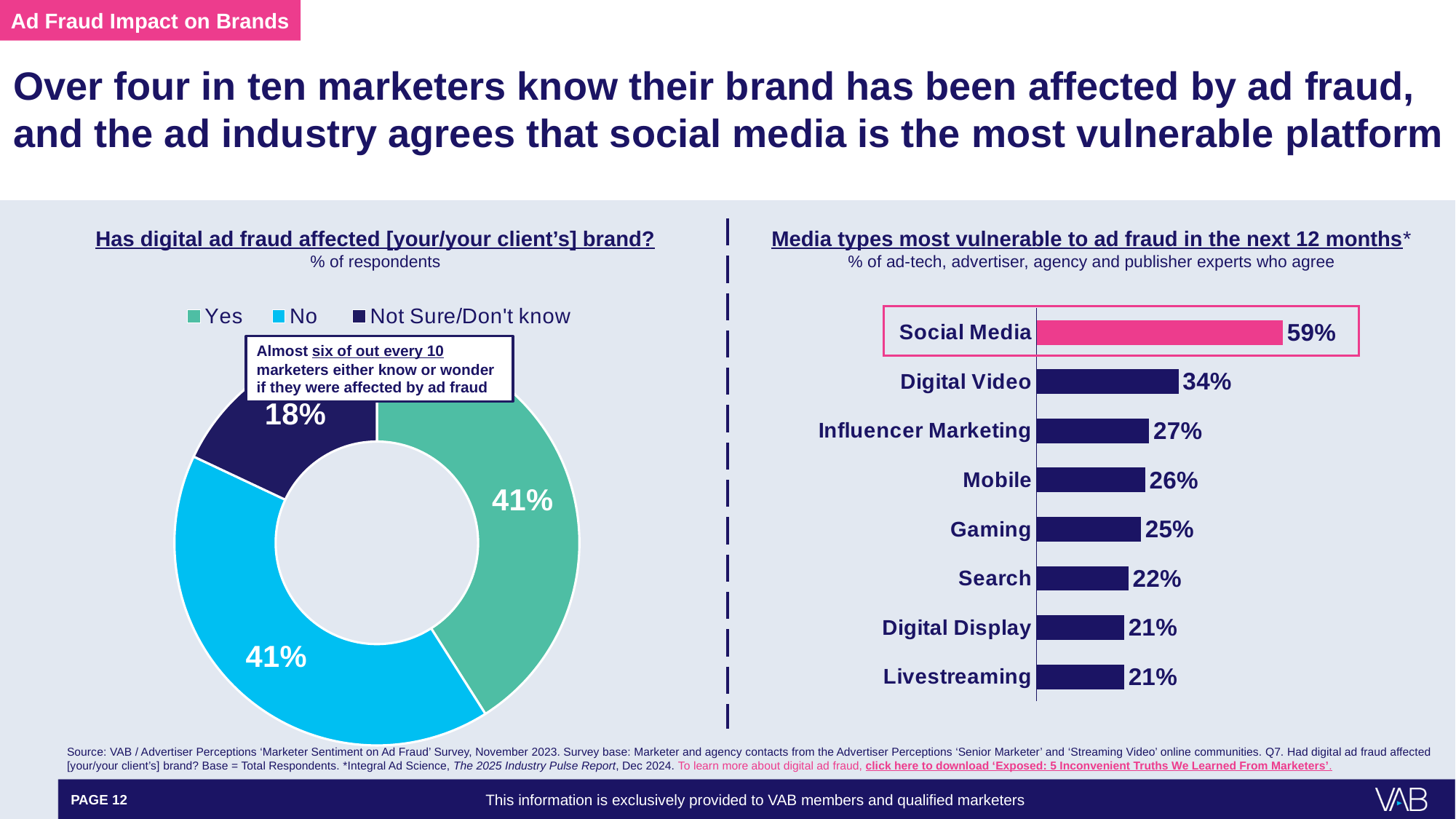
In the 'Media types most vulnerable to ad fraud in the next 12 months' chart, which bar is coloured pink rather than dark navy? Social Media What kind of chart is the 'Has digital ad fraud affected [your/your client's] brand?' chart? Donut (pie) chart How many entries does the legend of the 'Has digital ad fraud affected [your/your client's] brand?' chart list? 3 In the 'Has digital ad fraud affected [your/your client's] brand?' chart, what percentage of respondents answered Yes? 41% In the 'Media types most vulnerable to ad fraud in the next 12 months' chart, which is larger, Mobile or Gaming? Mobile In the 'Media types most vulnerable to ad fraud in the next 12 months' chart, what is the difference between Social Media and Digital Video? 25 percentage points In the 'Media types most vulnerable to ad fraud in the next 12 months' chart, which media type has the highest value? Social Media In the 'Media types most vulnerable to ad fraud in the next 12 months' chart, what percentage of experts agree for Digital Video? 34% How many media types are shown in the 'Media types most vulnerable to ad fraud in the next 12 months' chart? 8 In the 'Has digital ad fraud affected [your/your client's] brand?' chart, which response has the smallest share? Not Sure/Don't know What kind of chart is the 'Media types most vulnerable to ad fraud in the next 12 months' chart? Bar chart In the 'Has digital ad fraud affected [your/your client's] brand?' chart, what percentage of respondents answered Not Sure/Don't know? 18%